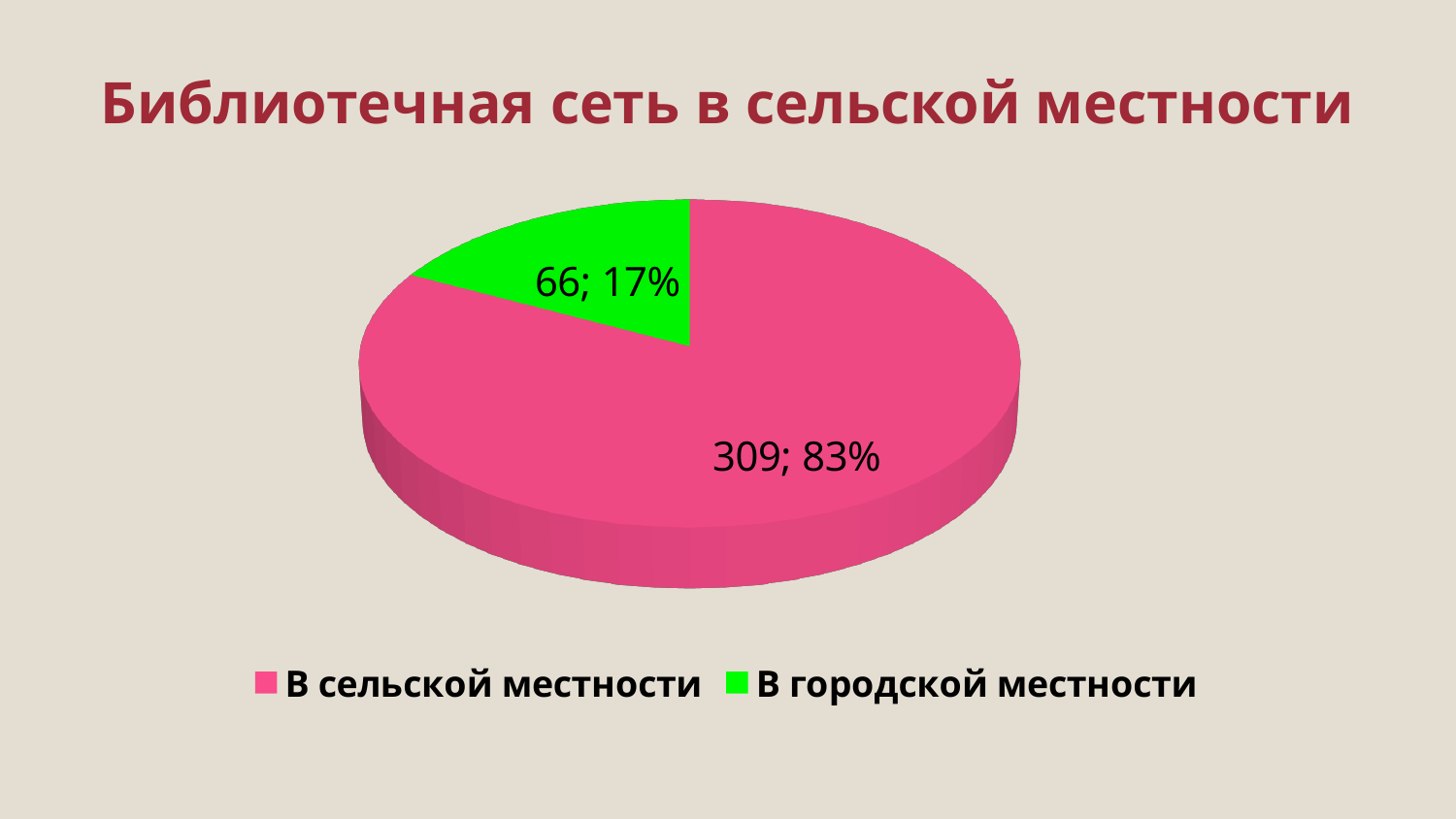
Which category has the smallest slice? В городской местности What is the value for "В сельской местности"? 309 What share of the pie does "В сельской местности" take? 83% How many slices does the pie chart have? 2 What is the total of the two values shown in the pie chart? 375 Which is larger: the value for "В сельской местности" or "В городской местности"? В сельской местности Which category has the largest slice? В сельской местности What is the value for "В городской местности"? 66 What share of the pie does "В городской местности" take? 17% What kind of chart is shown on the slide? Pie chart What is the difference between the values for "В сельской местности" and "В городской местности"? 243 What is the title of the chart? Библиотечная сеть в сельской местности